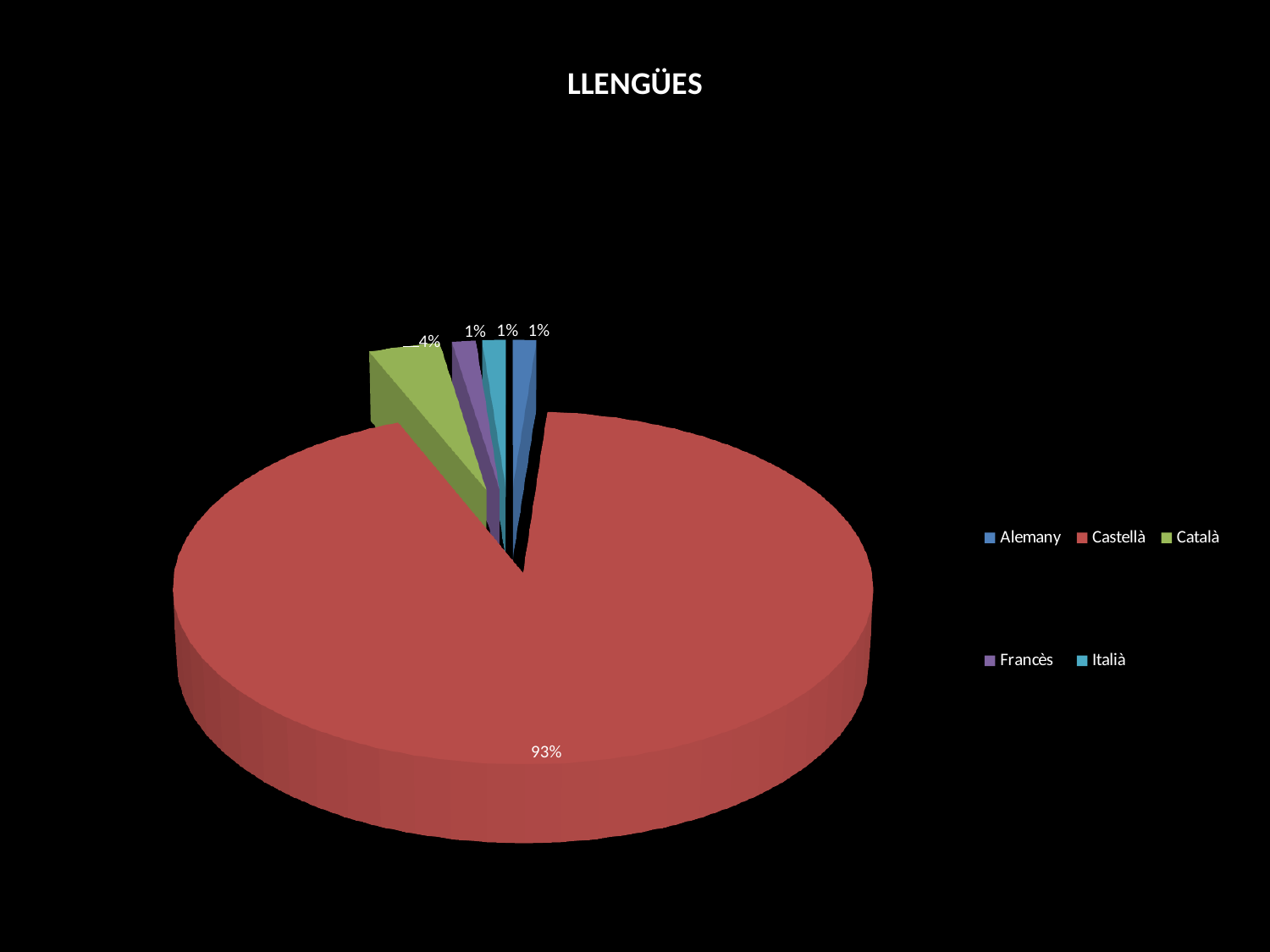
What is the value shown for Català? 4% What is the value shown for Italià? 1% What is the value shown for Francès? 1% What is the value shown for Alemany? 1% How many categories are shown in the pie chart? 5 What kind of chart is shown on the slide? Pie chart Which language is represented by the red slice? Castellà Which is larger, the slice for Català or the slice for Francès? Català What is the title of the chart? LLENGÜES Which language has the largest slice of the pie? Castellà What share of the pie does Castellà have? 93% What is the difference in percentage points between Castellà and Català? 89